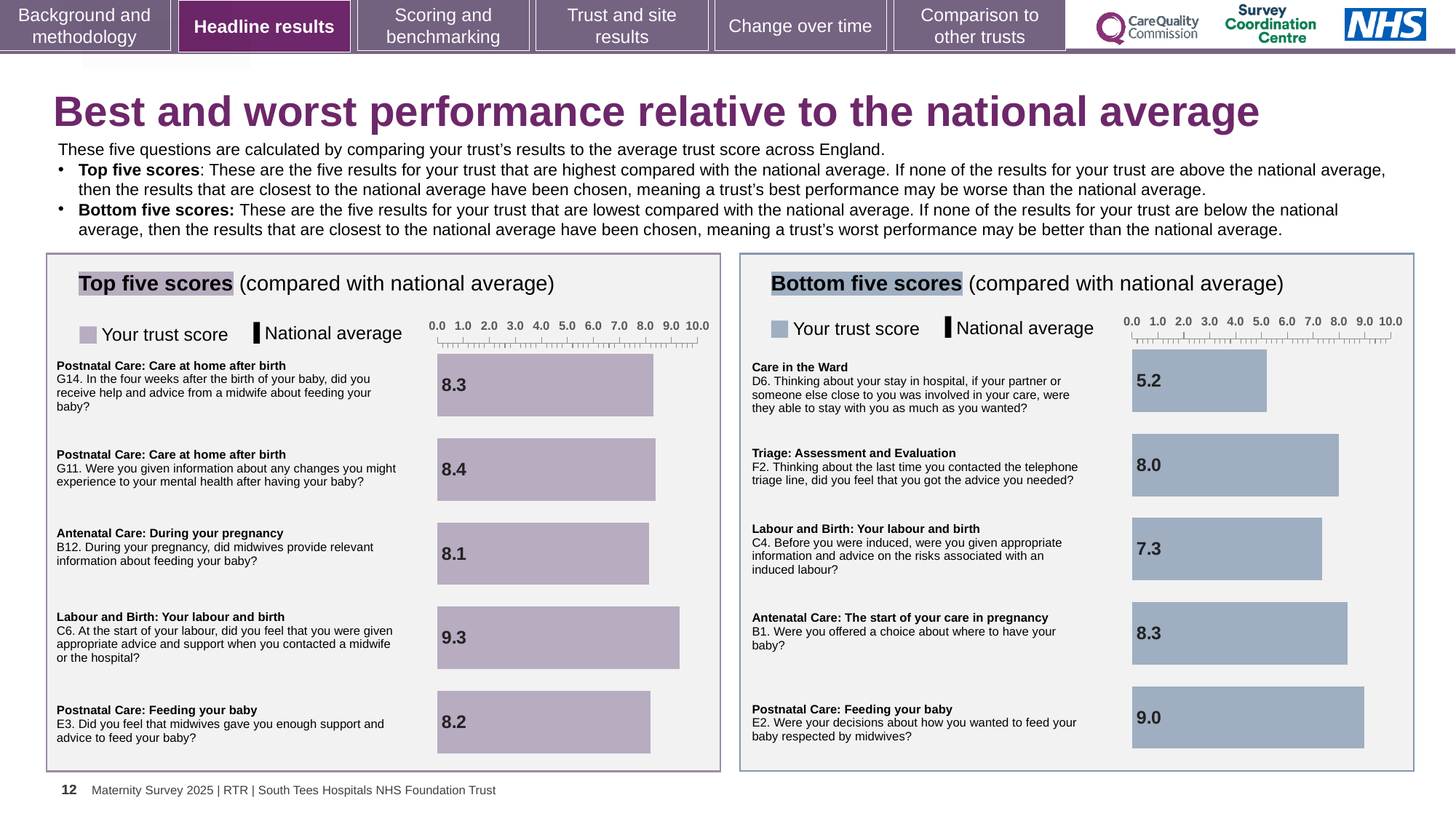
In the Bottom five scores chart, which question has the lowest trust score? D6 (Care in the Ward) In the Bottom five scores chart, which has the larger trust score, F2 or B1? B1 What type of chart is the Bottom five scores chart? Bar chart In the Top five scores chart, which question has the highest trust score? C6 (Labour and Birth: Your labour and birth) In the Bottom five scores chart, is the trust score for E2 greater or less than 8.0? greater How many series does the legend of the Top five scores chart list? 2 How many bars are shown in the Top five scores chart? 5 In the Top five scores chart, what is the trust score for question G11 (Postnatal Care: Care at home after birth)? 8.4 In the Bottom five scores chart, what is the trust score for question D6 (Care in the Ward)? 5.2 In the Bottom five scores chart, what is the difference between the trust scores for E2 and D6? 3.8 In the Top five scores chart, what is the difference between the trust scores for C6 and B12? 1.2 In the Top five scores chart, what is the trust score for question C6 (Labour and Birth: Your labour and birth)? 9.3